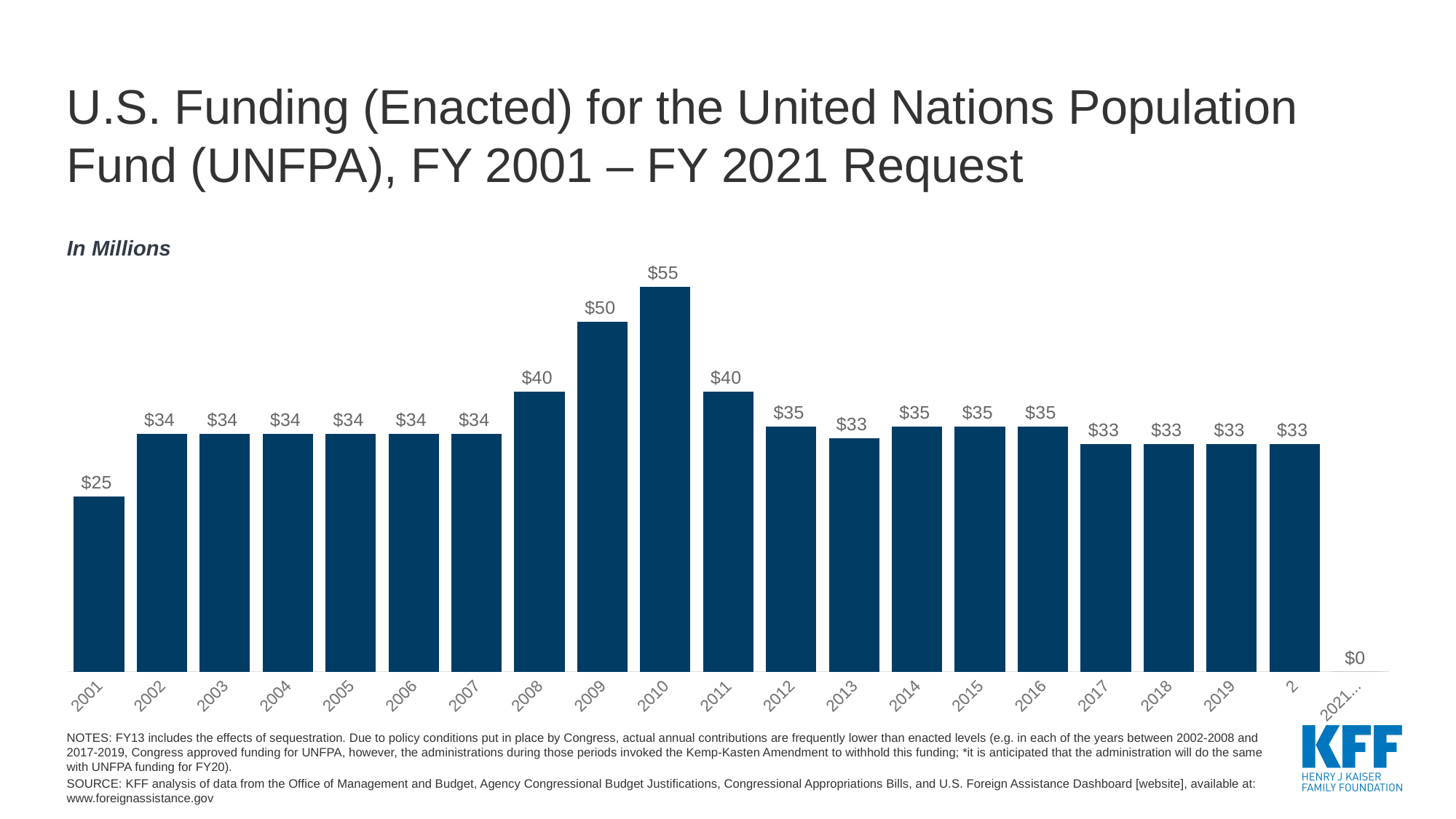
Do the funding values rise or fall from FY 2001 to FY 2010? Rise Which year has the larger funding value, 2008 or 2012? 2008 What is the enacted U.S. funding for UNFPA in FY 2001? $25 What is the difference between the funding in FY 2011 and FY 2001? $15 What is the enacted U.S. funding for UNFPA in FY 2013? $33 Which fiscal year has the highest enacted funding on the chart? 2010 What kind of chart is shown on the slide? Bar chart Among the years 2001 through 2019, which year has the lowest enacted funding? 2001 What is the enacted U.S. funding for UNFPA in FY 2010? $55 How many fiscal years are shown on the x axis of the chart? 21 What is the difference between the funding in FY 2010 and FY 2009? $5 In what units are the values on the chart expressed? In Millions